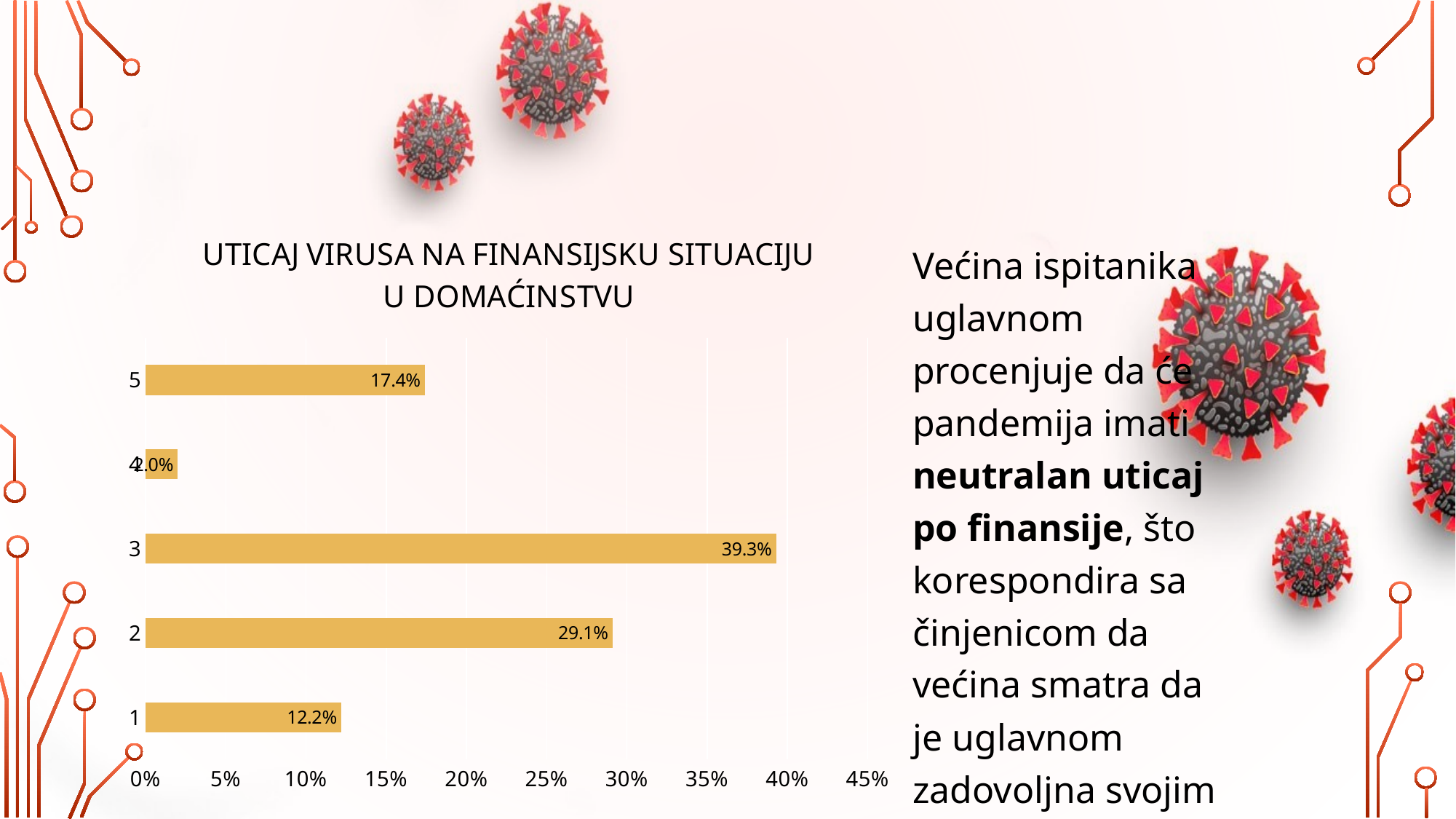
Is the value for category 4 greater or less than 5%? less How many categories are shown in the chart? 5 What is the title of the chart? UTICAJ VIRUSA NA FINANSIJSKU SITUACIJU U DOMAĆINSTVU What is the value for category 2? 29.1% Which is larger, the value for category 5 or the value for category 1? category 5 What is the value for category 3? 39.3% What type of chart is shown on the slide? bar chart What is the value for category 1? 12.2% Which category has the lowest value? 4 What is the value for category 5? 17.4% What is the difference between the values for category 3 and category 2? 10.2 percentage points Which category has the highest value? 3